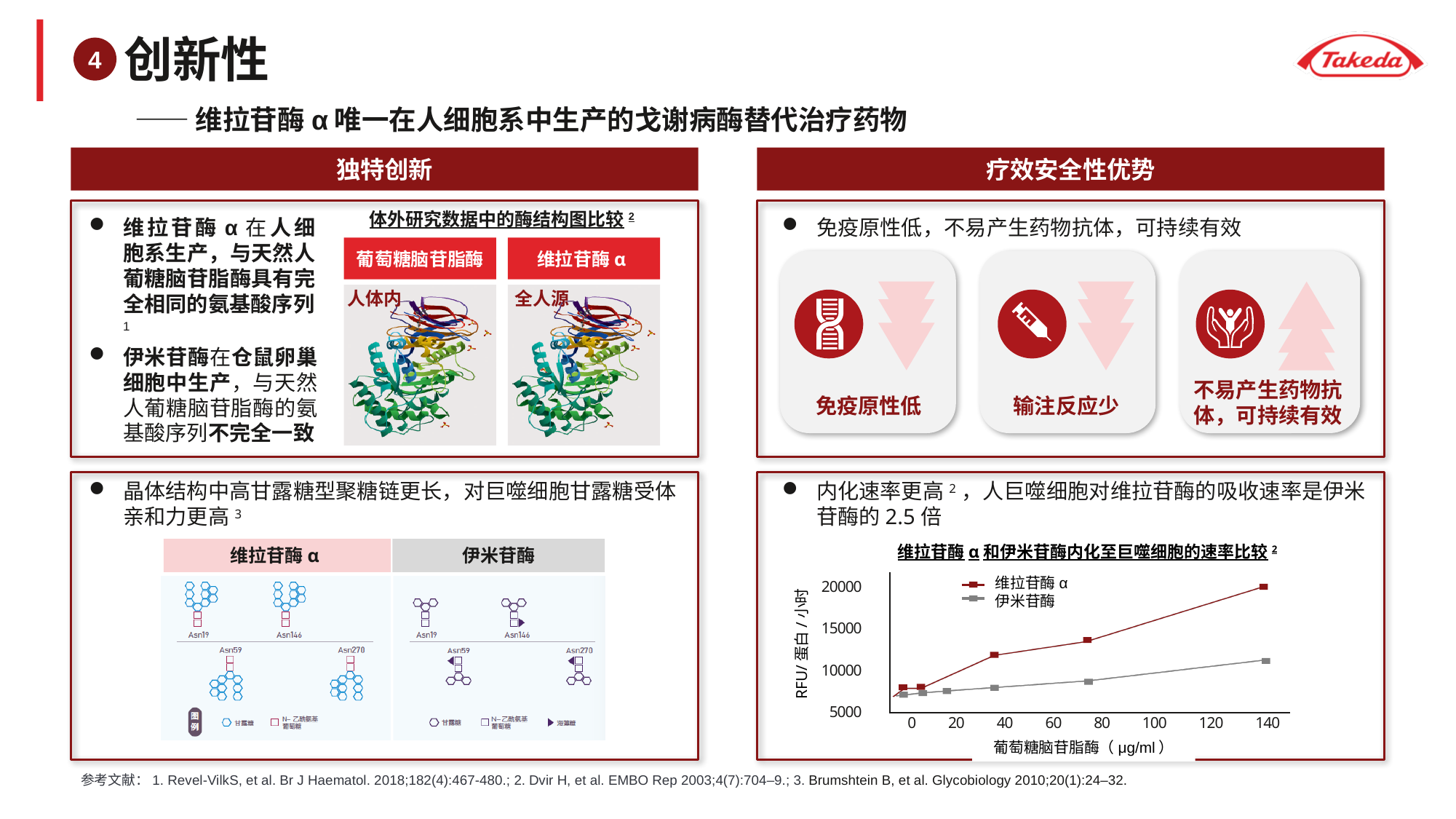
In the line chart, do the values for 维拉苷酶 α rise or fall as the glucocerebrosidase concentration increases? rise What kind of chart is shown under the title '维拉苷酶 α 和伊米苷酶内化至巨噬细胞的速率比较'? line chart In the line chart, is the value for 维拉苷酶 α at about 40 μg/ml greater or less than 10000? greater What is the x-axis label of the line chart? 葡萄糖脑苷脂酶（μg/ml） Which series in the line chart is drawn in red? 维拉苷酶 α In the line chart, which series has the higher value at 140 μg/ml? 维拉苷酶 α In the line chart, do the values for 伊米苷酶 rise or fall along the x axis? rise In the line chart, is the value for 维拉苷酶 α at 140 μg/ml greater or less than 15000? greater How many series does the legend of the line chart list? 2 In the line chart, is the value for 伊米苷酶 at 140 μg/ml greater or less than 10000? greater